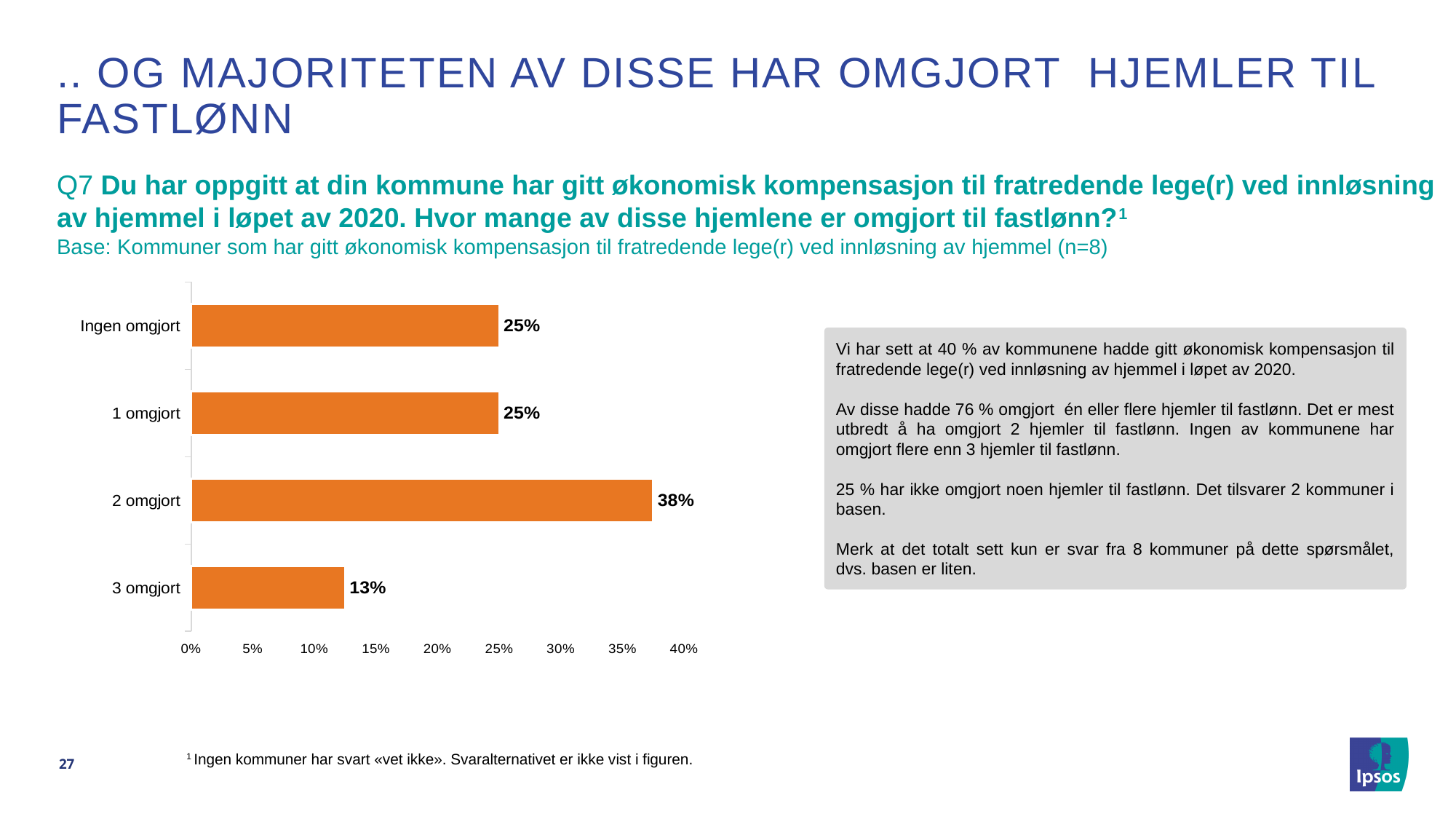
Which category has the highest value? 2 omgjort What is the value for "Ingen omgjort"? 25% Which is larger, the value for "2 omgjort" or the value for "1 omgjort"? 2 omgjort Is the value for "3 omgjort" greater or less than 15%? less What is the highest value shown on the x axis? 40% How many categories are shown in the chart? 4 What kind of chart is shown on the slide? Bar chart What is the value for "3 omgjort"? 13% What is the value for "1 omgjort"? 25% What is the value for "2 omgjort"? 38% What is the difference between the values for "2 omgjort" and "3 omgjort"? 25% Which category has the lowest value? 3 omgjort